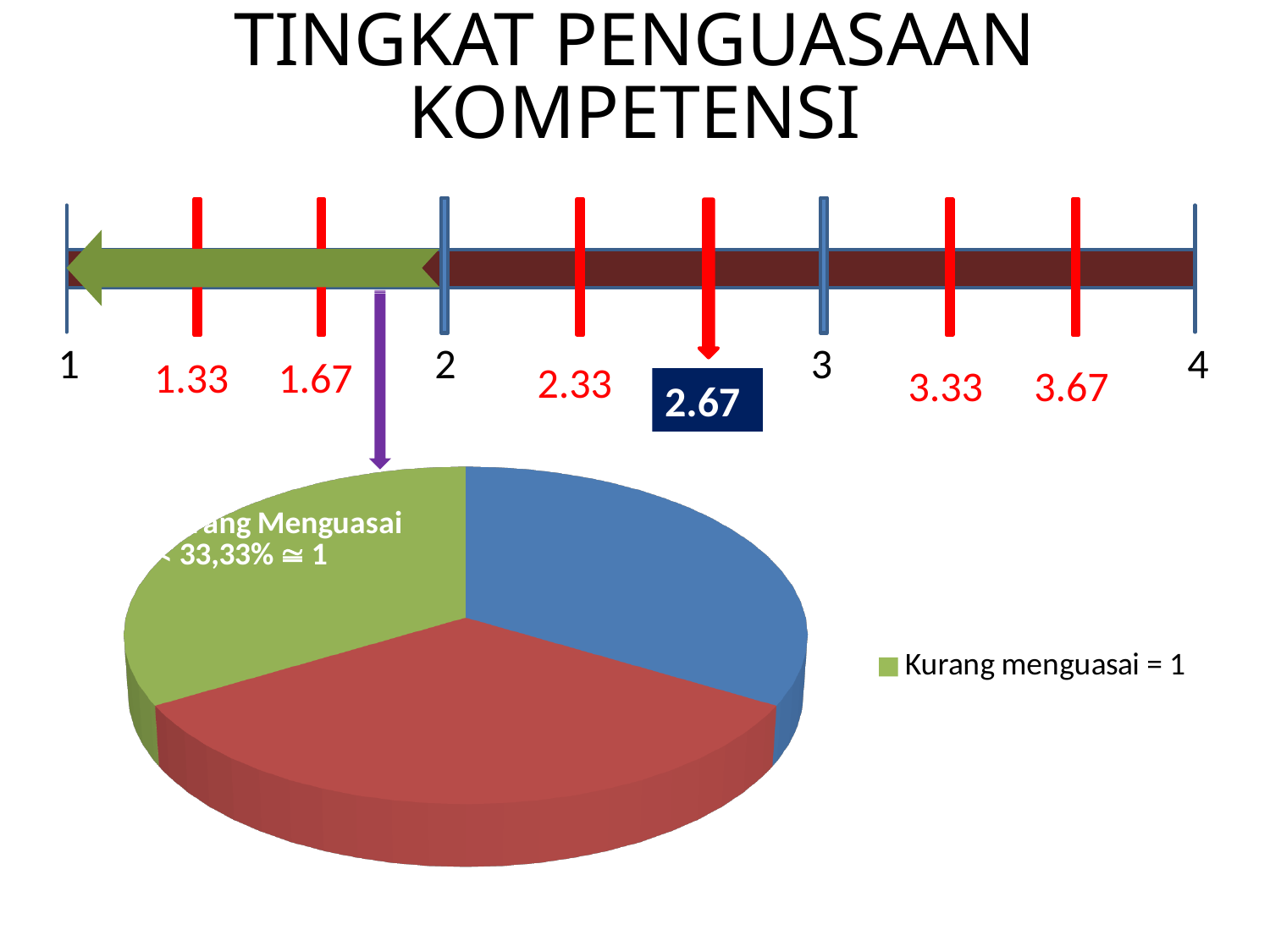
What percentage figure is printed in the label on the green slice of the pie chart? 33,33% What is the text of the legend entry shown next to the pie chart? Kurang menguasai = 1 What kind of chart is shown on the slide? pie chart What colour is the slice labelled "Kurang menguasai" in the pie chart? green How many entries does the pie chart's legend list? 1 How many slices does the pie chart have? 3